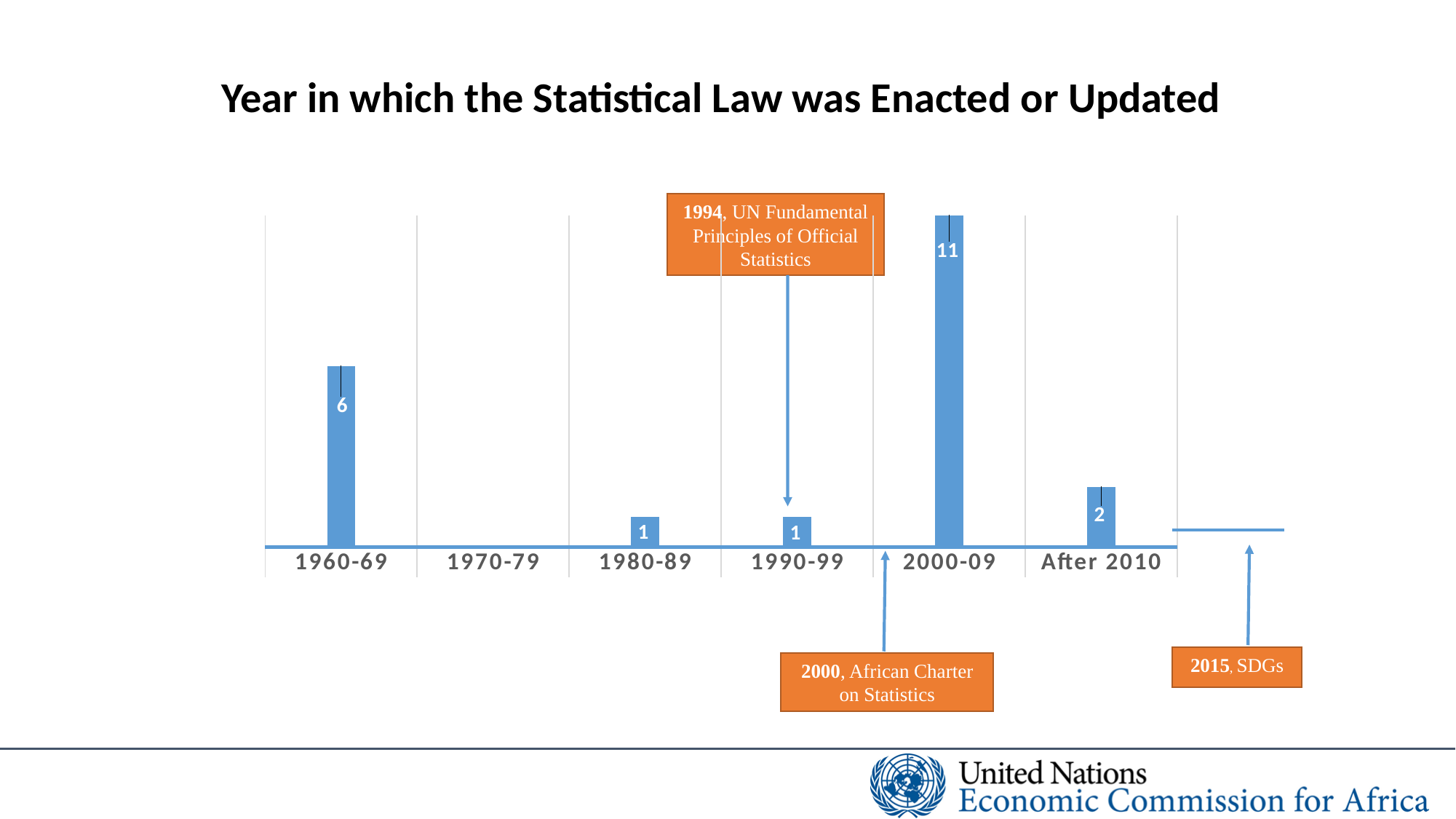
What is the value for 1960-69? 6 Which period has the highest value? 2000-09 What kind of chart is shown on the slide? Bar chart Which is larger, the value for 1960-69 or the value for After 2010? 1960-69 What is the value for 2000-09? 11 Which event does the annotation box for 1994 refer to? UN Fundamental Principles of Official Statistics What is the difference between the values for 2000-09 and 1960-69? 5 How many periods are shown on the x axis? 6 Which period has no bar shown (a value of zero)? 1970-79 What is the value for After 2010? 2 What is the value for 1980-89? 1 What is the title of the chart? Year in which the Statistical Law was Enacted or Updated